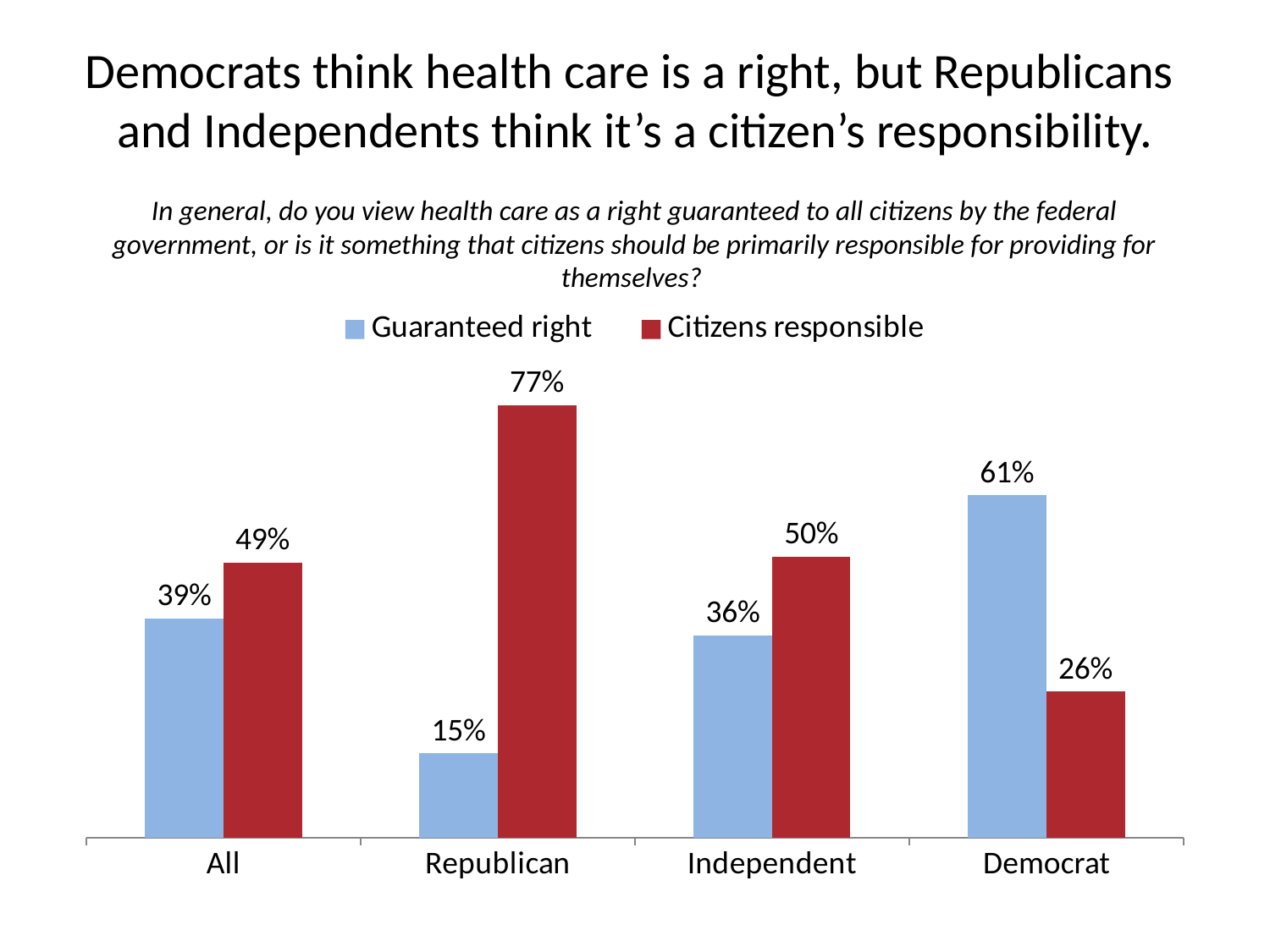
What percentage of Democrats view health care as a guaranteed right? 61% What is the difference between the 'Guaranteed right' value for Democrats and for Independents? 25 percentage points What is the difference between the 'Citizens responsible' and 'Guaranteed right' values for Republicans? 62 percentage points For Democrats, which is larger: 'Guaranteed right' or 'Citizens responsible'? Guaranteed right How many series does the legend list? 2 What is the 'Citizens responsible' value for the 'All' category? 49% What is the 'Guaranteed right' value for Independents? 36% Which category has the lowest 'Guaranteed right' value? Republican How many categories are shown on the x axis? 4 What kind of chart is shown on the slide? Bar chart What percentage of Republicans say citizens are responsible for health care? 77% Which category has the highest 'Citizens responsible' value? Republican